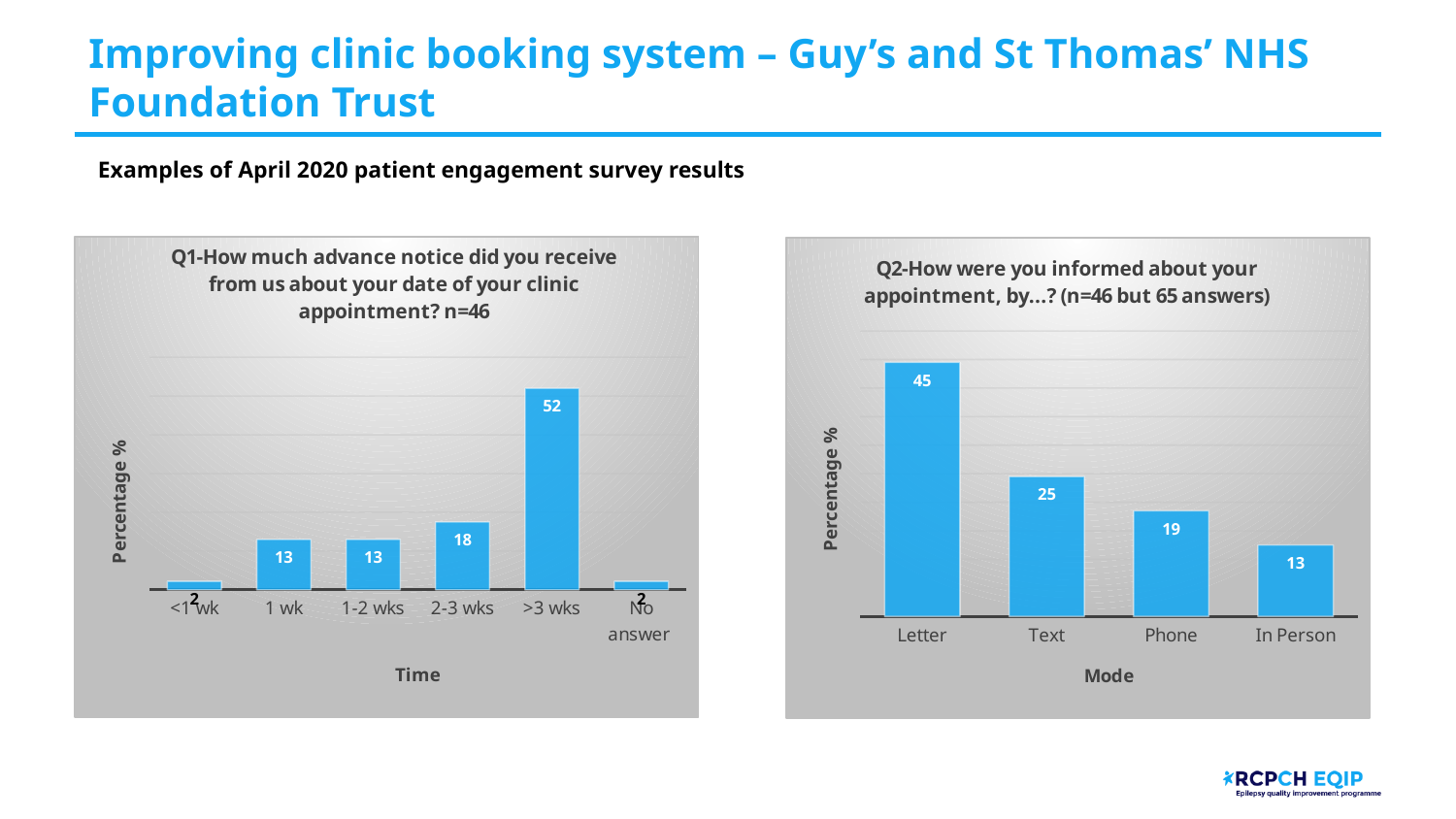
In the Q1 chart (left), what percentage of respondents received more than 3 weeks' notice (>3 wks)? 52 In the Q2 chart (right), what is the value for Letter? 45 In the Q1 chart (left), which is larger, the value for 1 wk or the value for 2-3 wks? 2-3 wks In the Q1 chart (left), what is the value for 2-3 wks? 18 What kind of chart is the Q2 chart (right)? bar chart In the Q1 chart (left), how many time categories are shown on the x axis? 6 In the Q2 chart (right), what is the difference between the values for Letter and Text? 20 In the Q1 chart (left), what is the difference between the values for >3 wks and 2-3 wks? 34 What is the x-axis title of the Q2 chart (right)? Mode In the Q1 chart (left), which time category has the highest value? >3 wks In the Q2 chart (right), which mode has the lowest value? In Person In the Q2 chart (right), do the values rise or fall from Letter to In Person along the x axis? fall